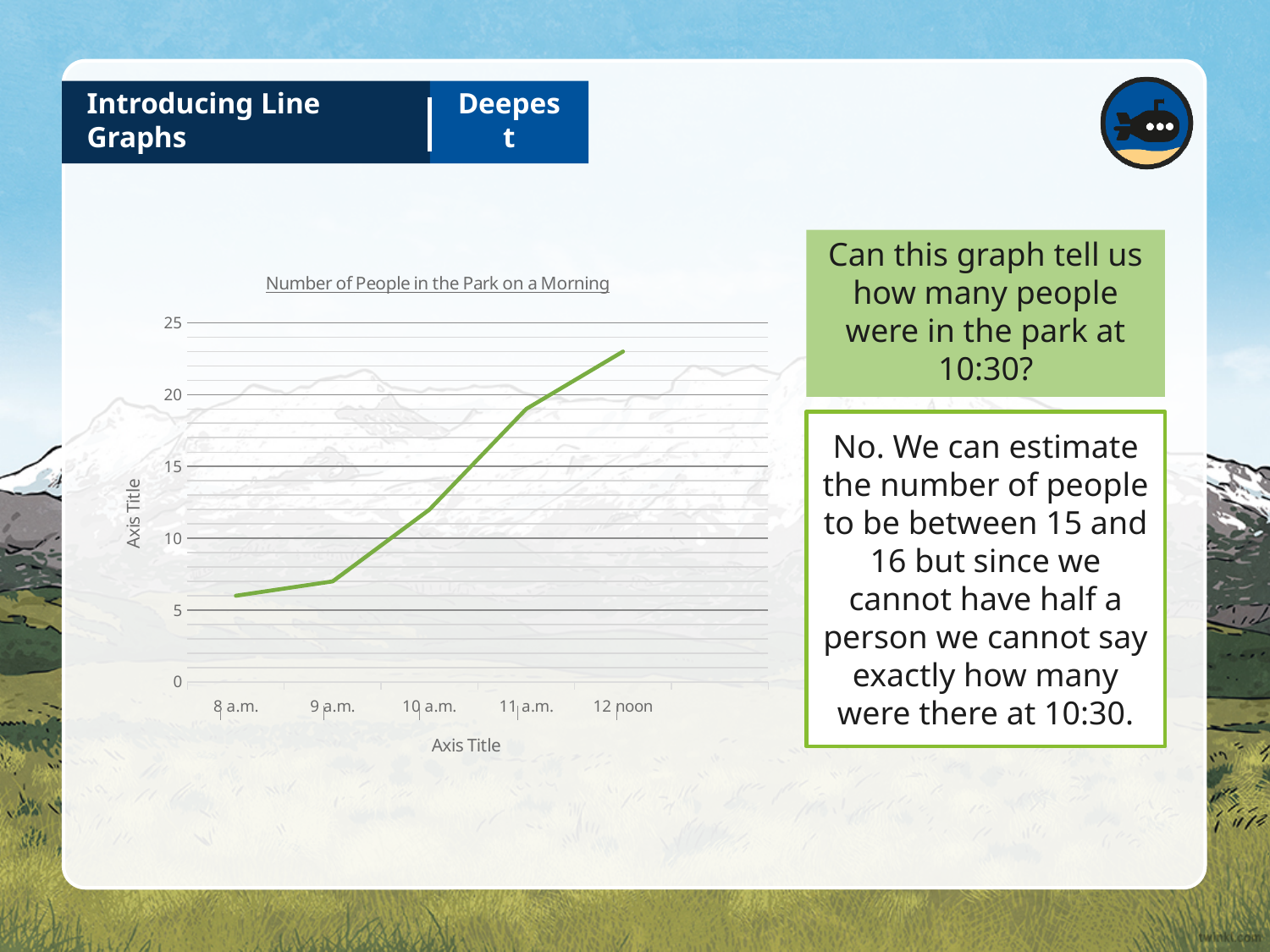
What is the title of the chart? Number of People in the Park on a Morning How many time points are plotted on the x axis? 5 Is the value for 11 a.m. greater or less than 15? greater What colour is the plotted line? green Is the value for 8 a.m. greater or less than 10? less Which has a larger value, 9 a.m. or 11 a.m.? 11 a.m. What kind of chart is shown on the slide? line chart Do the values rise or fall from 8 a.m. to 12 noon? rise Is the value for 12 noon greater or less than 20? greater At which time is the number of people in the park highest? 12 noon At which time is the number of people in the park lowest? 8 a.m.